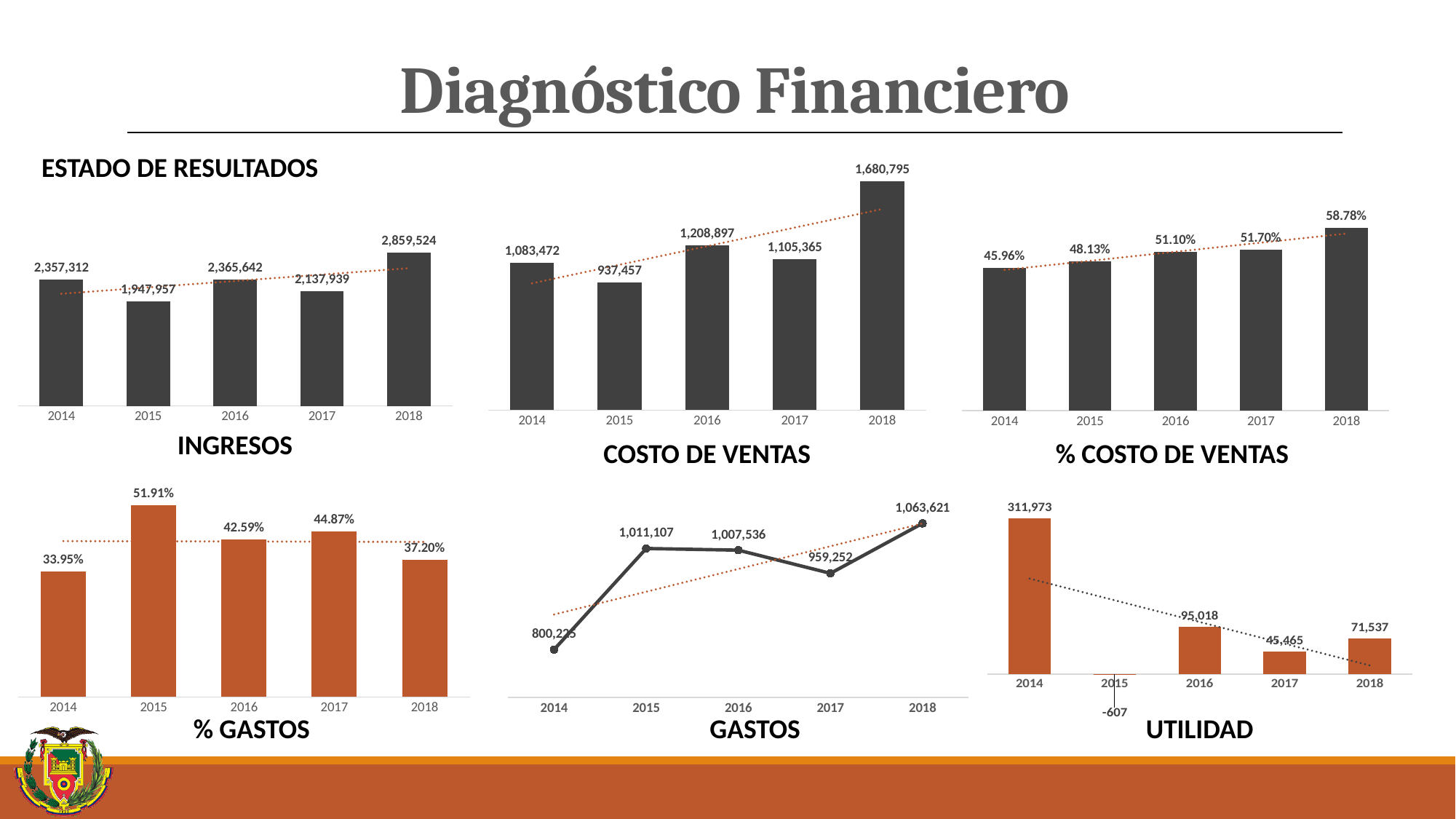
In the COSTO DE VENTAS chart, what is the value for 2016? 1,208,897 In the UTILIDAD chart, what is the value for 2015? -607 In the COSTO DE VENTAS chart, which year has the highest value? 2018 In the INGRESOS chart, what is the difference between the 2018 and 2014 values? 502,212 In the GASTOS chart, what is the value for 2017? 959,252 In the % COSTO DE VENTAS chart, do the values rise or fall from 2014 to 2018? rise In the % GASTOS chart, which year has the highest value? 2015 In the INGRESOS chart, which year has the lowest value? 2015 In the INGRESOS chart, what is the value for 2018? 2,859,524 What kind of chart is the GASTOS chart? line chart In the % COSTO DE VENTAS chart, what is the value for 2014? 45.96% In the % GASTOS chart, which is larger, the value for 2016 or the value for 2017? 2017